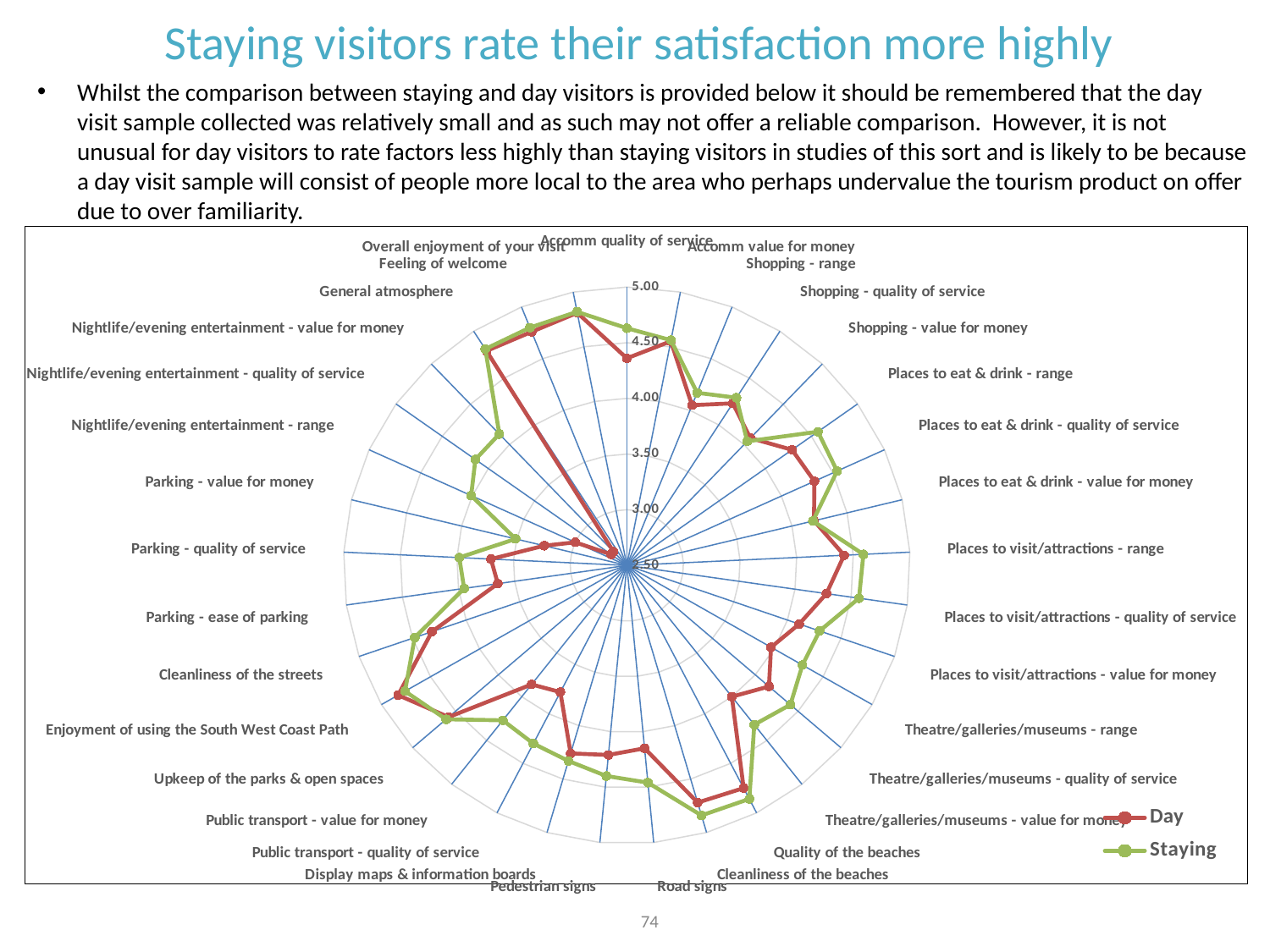
How many series does the legend list? 2 Is the Staying value for Feeling of welcome greater or less than 4.50? greater Which colour represents the Staying series? Green What kind of chart is shown on the slide? Radar chart For Nightlife/evening entertainment - range, which series has the higher value, Day or Staying? Staying For Road signs, which series has the higher value, Day or Staying? Staying What are the two series named in the legend? Day and Staying For Places to visit/attractions - range, which series has the higher value, Day or Staying? Staying What is the highest value shown on the chart's axis scale? 5.00 What is the lowest value shown on the chart's axis scale? 2.50 Is the Staying value for Enjoyment of using the South West Coast Path greater or less than 4.00? greater Is the Day value for Nightlife/evening entertainment - value for money greater or less than 3.00? less